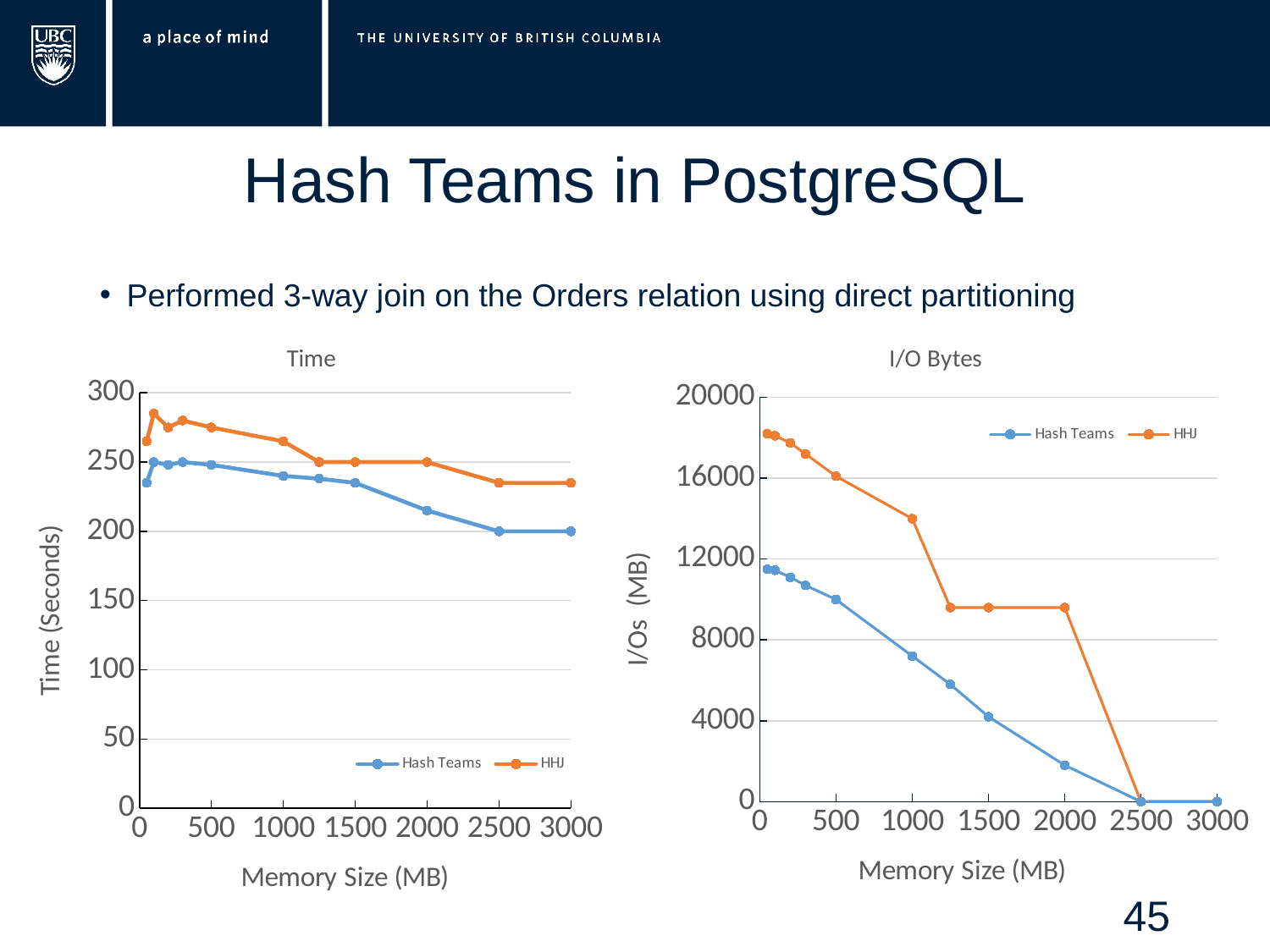
In the "I/O Bytes" chart, do the Hash Teams values rise or fall as memory size increases? fall In the "I/O Bytes" chart, is the HHJ value at 1000 MB greater or less than 12000? greater In the "I/O Bytes" chart, is the Hash Teams value at 2000 MB greater or less than 4000? less How many series does the legend of the "I/O Bytes" chart list? 2 What is the x-axis label of the "I/O Bytes" chart? Memory Size (MB) In the "Time" chart, which series is plotted in orange? HHJ In the "I/O Bytes" chart, is the Hash Teams value at 1000 MB greater or less than 8000? less In the "I/O Bytes" chart, which series has the larger value at 1000 MB, Hash Teams or HHJ? HHJ What kind of chart is the chart titled "Time"? line chart